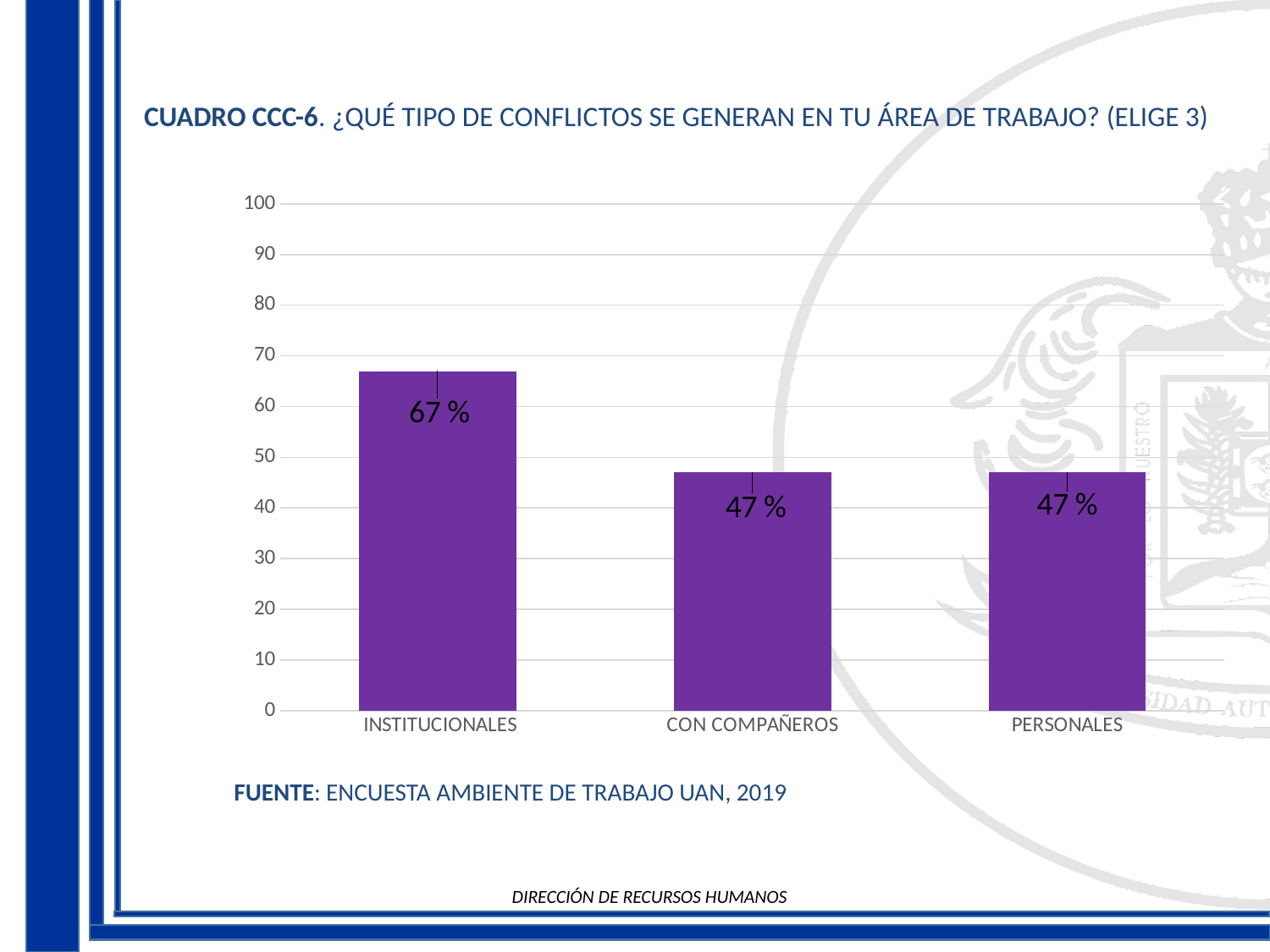
What is the maximum value shown on the vertical axis? 100 Is the value for INSTITUCIONALES greater or less than 60? greater Which is larger, the value for INSTITUCIONALES or the value for PERSONALES? INSTITUCIONALES What source is cited below the chart? ENCUESTA AMBIENTE DE TRABAJO UAN, 2019 How many categories are shown on the x axis? 3 What is the difference between the values for INSTITUCIONALES and CON COMPAÑEROS? 20 % Is the value for PERSONALES greater or less than 50? less What is the value for CON COMPAÑEROS? 47 % Which category has the highest value? INSTITUCIONALES What is the value for INSTITUCIONALES? 67 % What kind of chart is shown on the slide? bar chart What is the value for PERSONALES? 47 %